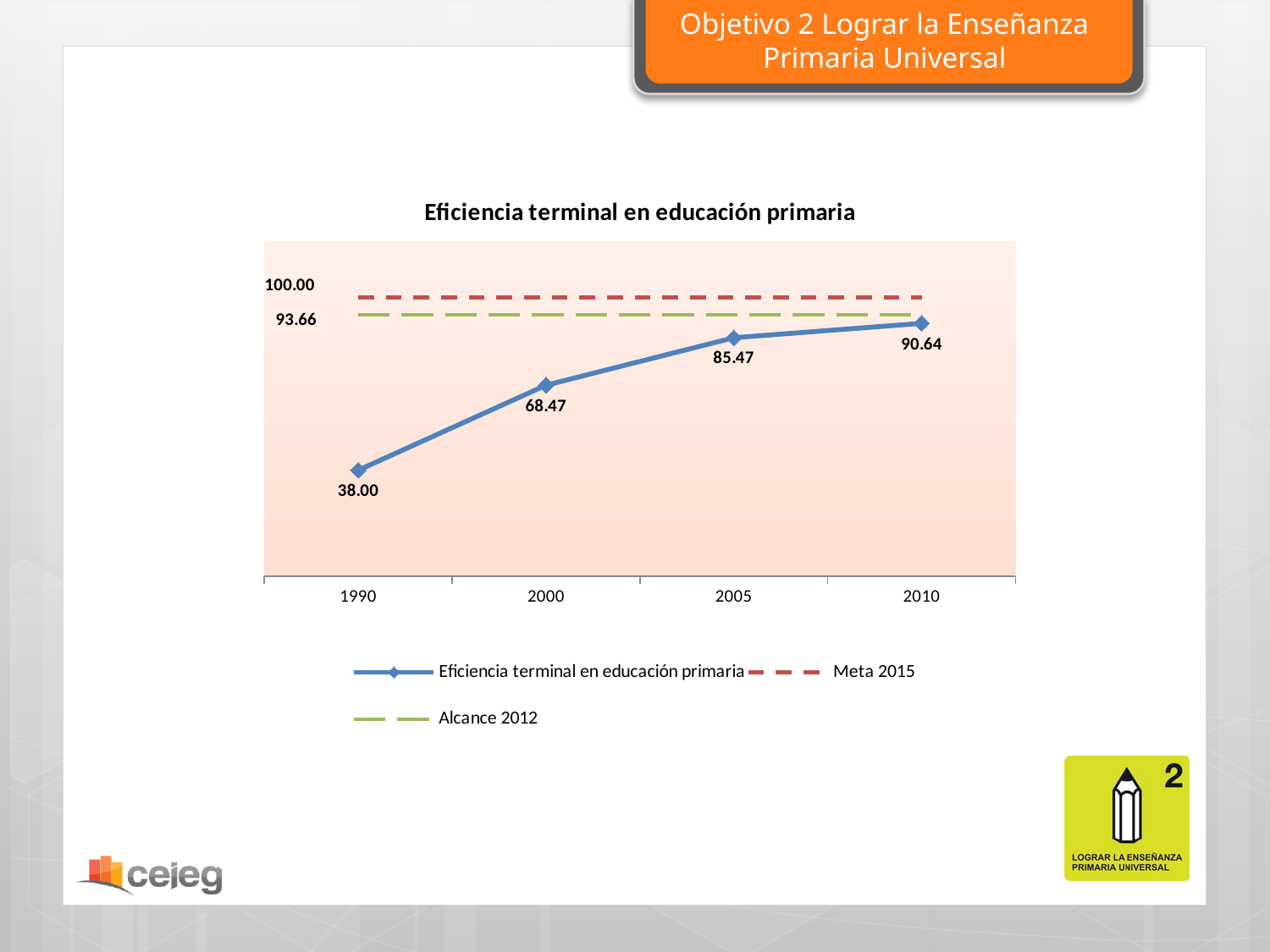
Which year has the lowest value of Eficiencia terminal en educación primaria? 1990 What is the value of Eficiencia terminal en educación primaria for 2005? 85.47 What value is shown for the Alcance 2012 line? 93.66 What is the value of Eficiencia terminal en educación primaria for 2010? 90.64 How many series does the legend list? 3 What kind of chart is shown on the slide? line chart Does the Eficiencia terminal en educación primaria line rise or fall from 1990 to 2010? rise Which year has the highest value of Eficiencia terminal en educación primaria? 2010 What is the value of Eficiencia terminal en educación primaria for 1990? 38.00 What is the difference between the Eficiencia terminal values for 2010 and 1990? 52.64 What is the value of Eficiencia terminal en educación primaria for 2000? 68.47 What value is shown for the Meta 2015 line? 100.00